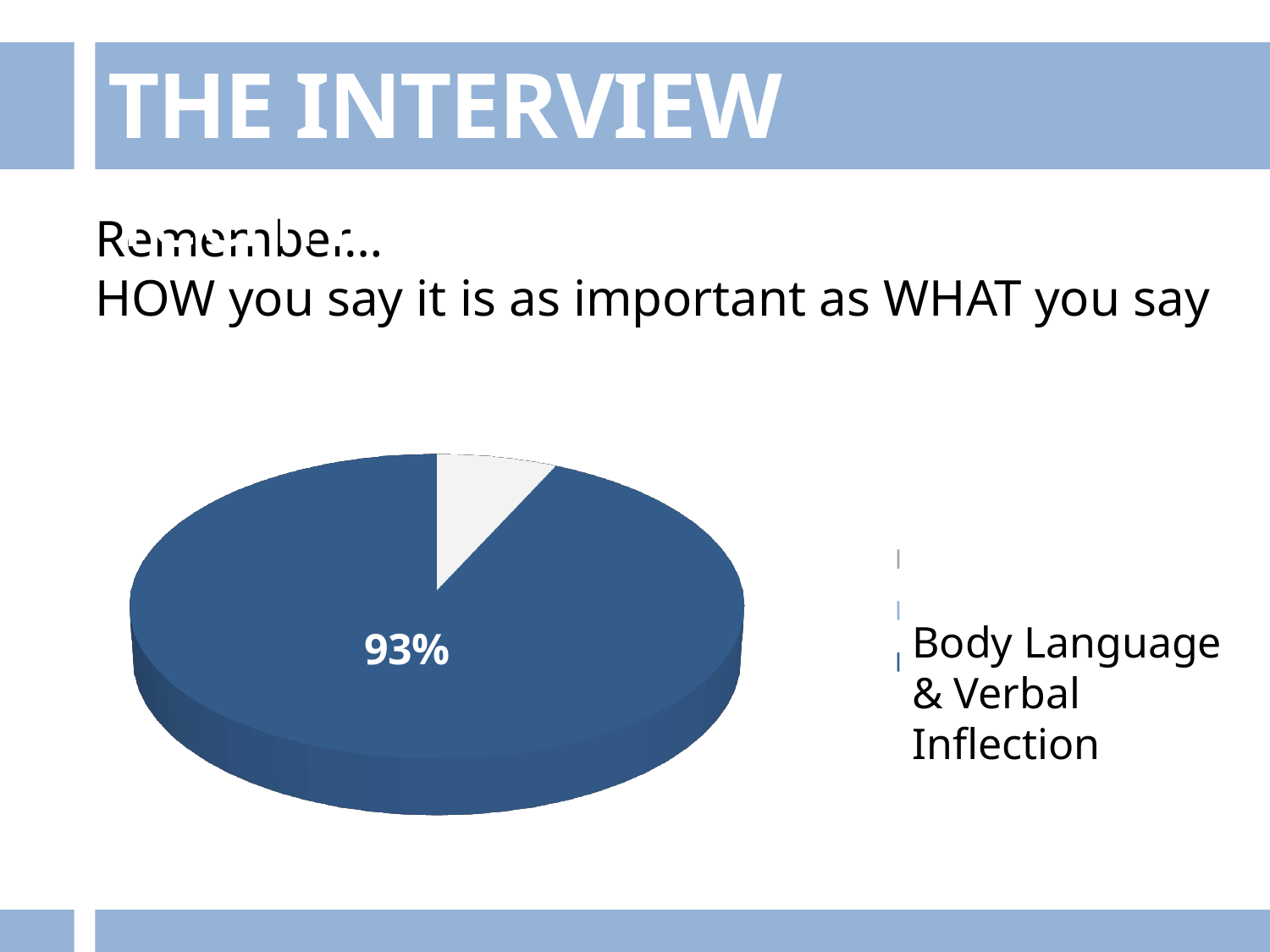
Which slice of the pie chart is larger, the blue slice or the white slice? the blue slice What colour is the largest slice of the pie chart? blue Is the white slice of the pie chart greater or less than 50% of the pie? less What is the readable legend entry next to the pie chart? Body Language & Verbal Inflection What value is printed on the large blue slice of the pie chart? 93% How many slices are visible in the pie chart? 2 What share of the pie does the large blue slice represent? 93% Is the blue slice of the pie chart greater or less than 50% of the pie? greater What kind of chart is shown on the slide? pie chart